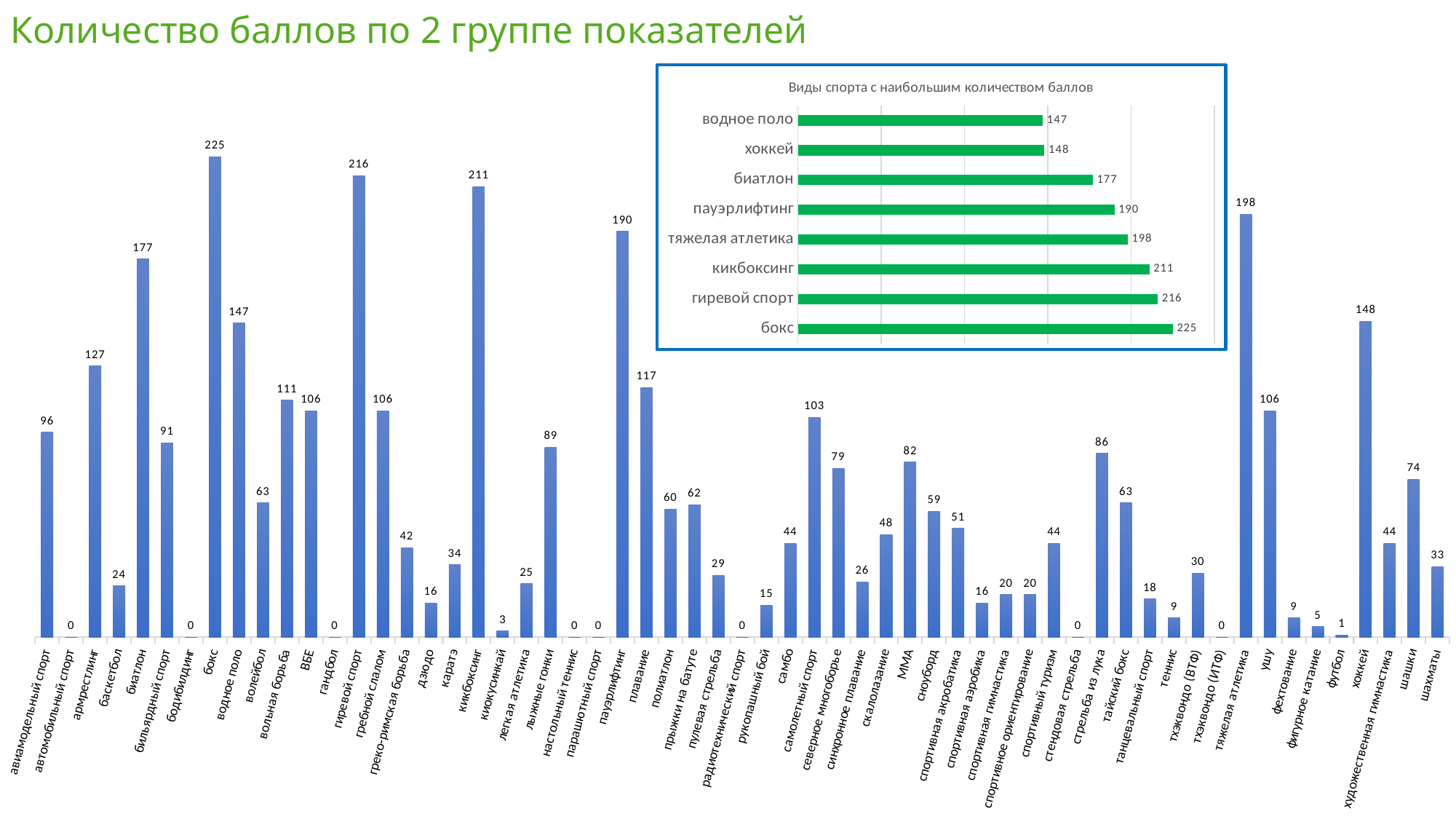
In the inset chart "Виды спорта с наибольшим количеством баллов", how many sports are listed? 8 In the main chart "Количество баллов по 2 группе показателей", what is the value for шашки? 74 What type of chart is the main chart "Количество баллов по 2 группе показателей"? bar chart In the main chart "Количество баллов по 2 группе показателей", what is the value for плавание? 117 In the main chart "Количество баллов по 2 группе показателей", which has the larger value, самолетный спорт or стрельба из лука? самолетный спорт In the inset chart "Виды спорта с наибольшим количеством баллов", what is the value for биатлон? 177 In the inset chart "Виды спорта с наибольшим количеством баллов", what is the difference between бокс and гиревой спорт? 9 In the main chart "Количество баллов по 2 группе показателей", which category has the highest value? бокс What is the title of the inset chart on the slide? Виды спорта с наибольшим количеством баллов In the inset chart "Виды спорта с наибольшим количеством баллов", which sport has the lowest value? водное поло In the inset chart "Виды спорта с наибольшим количеством баллов", which sport has the highest value? бокс In the main chart "Количество баллов по 2 группе показателей", what is the difference between тяжелая атлетика and хоккей? 50